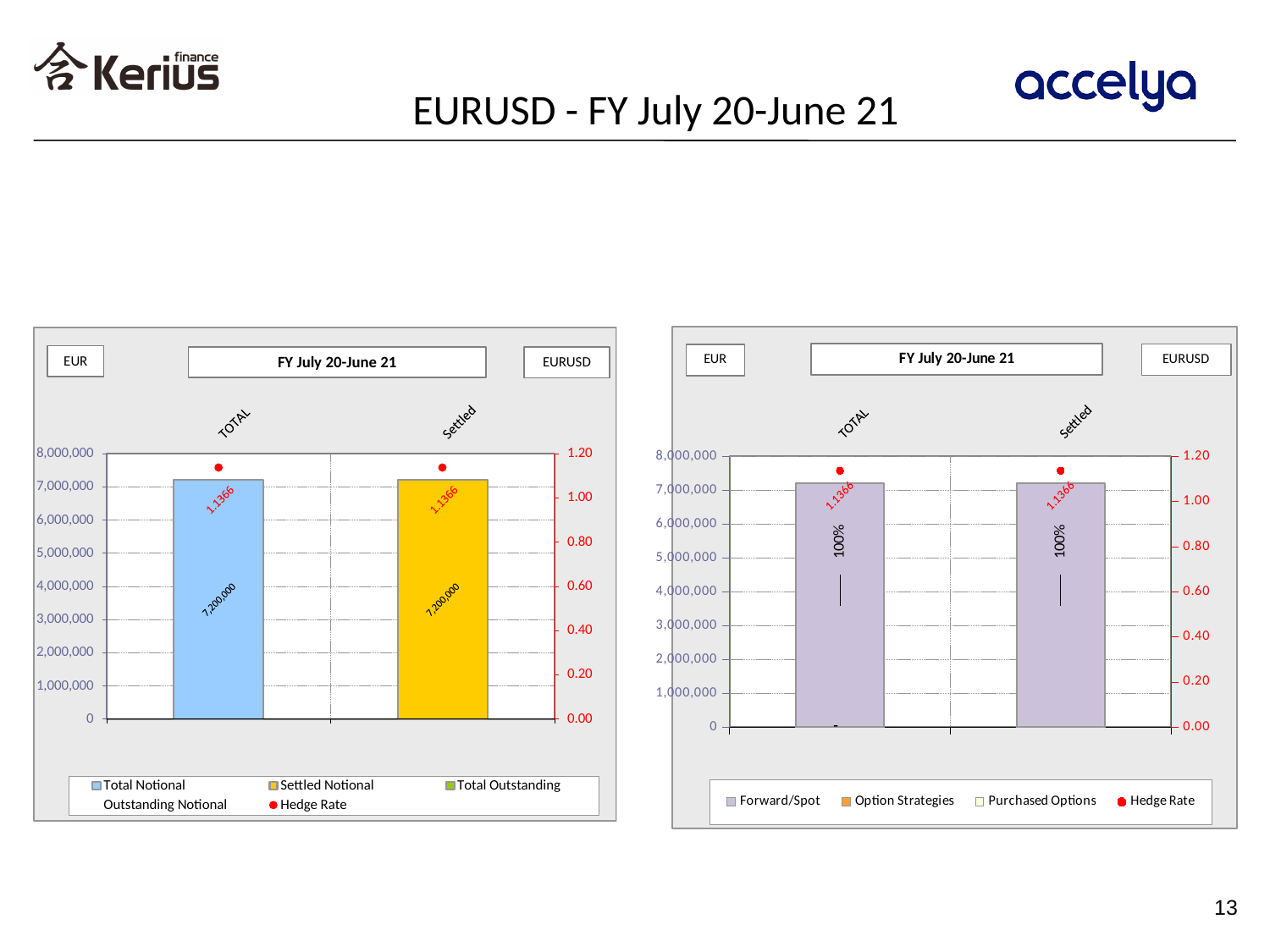
In the right chart, what is the Hedge Rate value shown for Settled? 1.1366 In the right chart, how many series does the legend list? 4 In the left chart, what is the difference between the TOTAL bar and the Settled bar? 0 In the left chart, what is the Hedge Rate value shown for TOTAL? 1.1366 What kind of chart is the left chart? Bar chart with a line/marker series for Hedge Rate In the left chart, how many categories are shown on the x axis? 2 In the left chart, what is the data label on the TOTAL bar? 7,200,000 In the right chart, which legend entry is represented by the red dot marker? Hedge Rate In the left chart, how many series does the legend list? 5 In the left chart, is the value for the TOTAL bar greater or less than 6,000,000? greater In the left chart, what is the data label on the Settled bar? 7,200,000 In the right chart, what percentage label is shown on the Settled bar? 100%